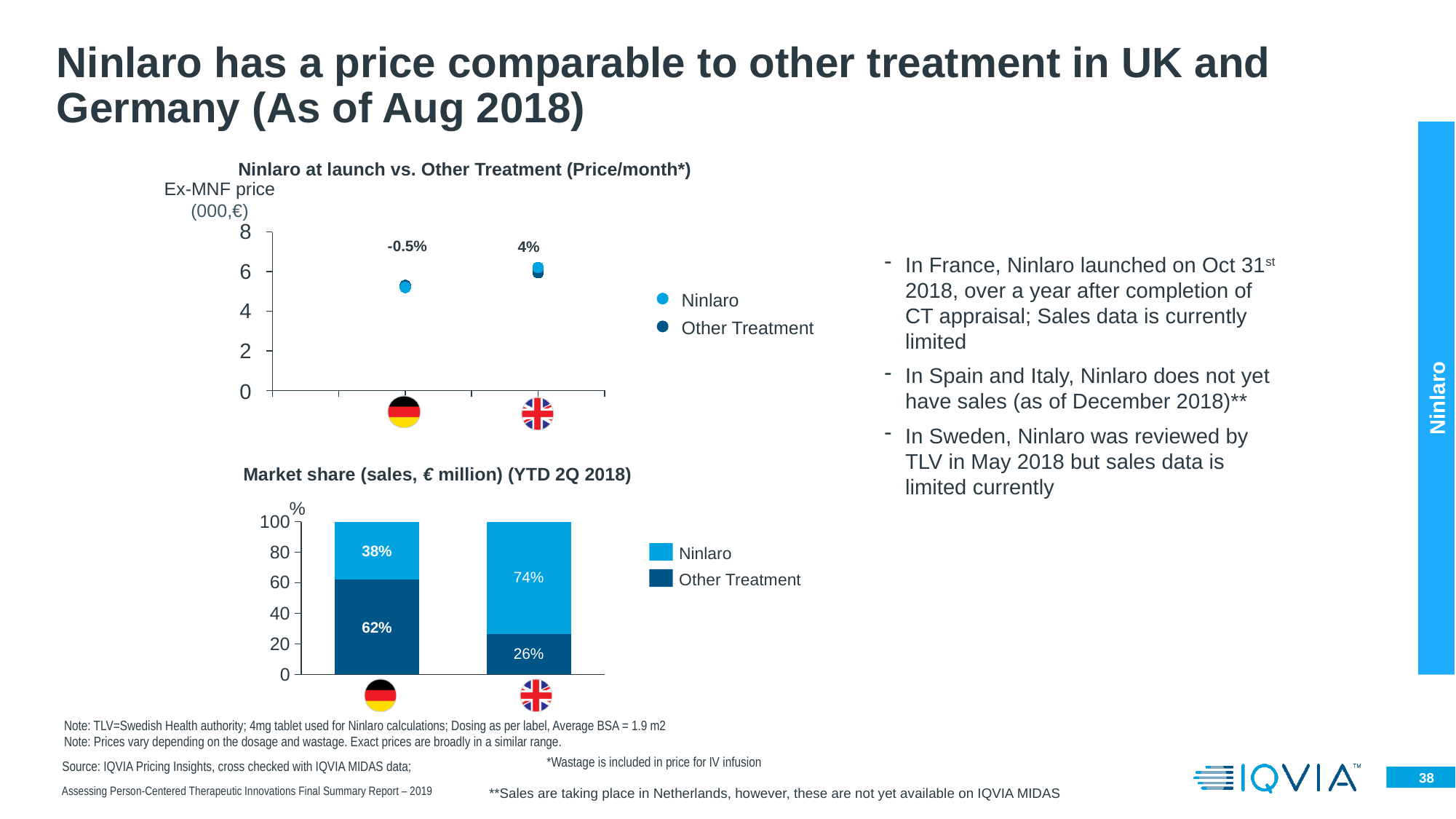
In the Ninlaro at launch vs. Other Treatment chart, is the Ninlaro price for the German flag greater or less than 6? less In the Market share chart, which country has the higher Ninlaro share, the one with the German flag or the one with the UK flag? UK flag In the Ninlaro at launch vs. Other Treatment chart, what percentage label is shown above the UK flag points? 4% In the Market share chart, what is the Other Treatment share for the country shown with the German flag? 62% In the Market share chart, what is the total of the stacked bar for the German flag? 100% In the Market share chart, what is the Ninlaro share for the country shown with the German flag? 38% In the Market share chart, what is the difference between the Ninlaro share for the UK flag and the Ninlaro share for the German flag? 36 percentage points How many series does the legend of the Market share chart list? 2 In the Ninlaro at launch vs. Other Treatment chart, what percentage label is shown above the German flag points? -0.5% In the Market share chart, what is the Other Treatment share for the country shown with the UK flag? 26% What kind of chart is the Market share chart? Stacked bar chart In the Market share chart, what is the Ninlaro share for the country shown with the UK flag? 74%